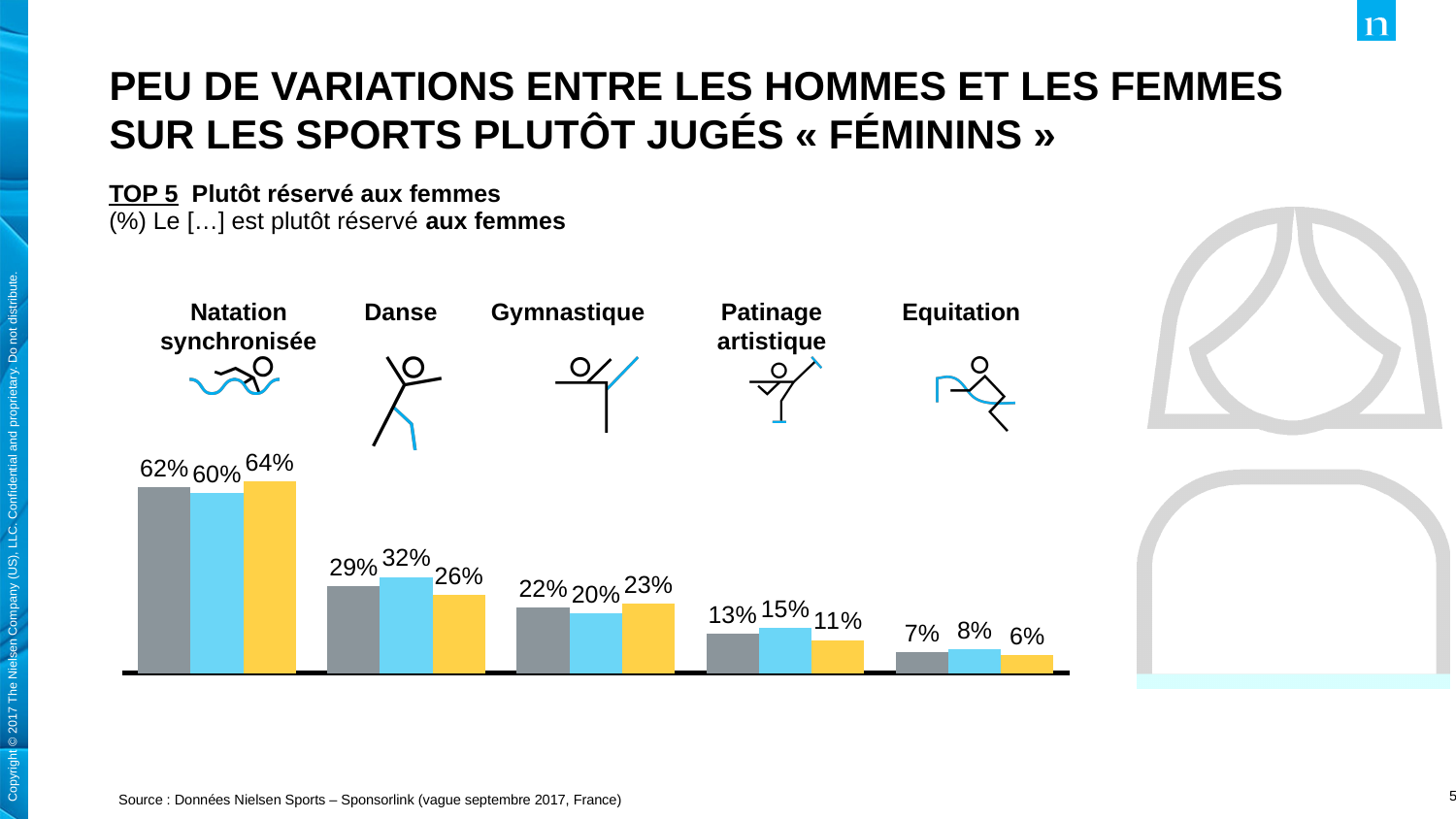
Which category has the lowest values overall? Equitation What is the difference between the yellow bar and the grey bar for Natation synchronisée? 2% What kind of chart is shown on the slide? bar chart What is the value of the yellow bar for Equitation? 6% What is the difference between the blue bar and the grey bar for Danse? 3% How many sport categories are shown in the chart? 5 What is the value of the blue bar for Patinage artistique? 15% Which category has the highest values overall? Natation synchronisée What is the value of the grey bar for Natation synchronisée? 62% What is the value of the yellow bar for Danse? 26% Do the values rise or fall moving from Natation synchronisée to Equitation? fall For Gymnastique, which is larger: the grey bar or the blue bar? the grey bar